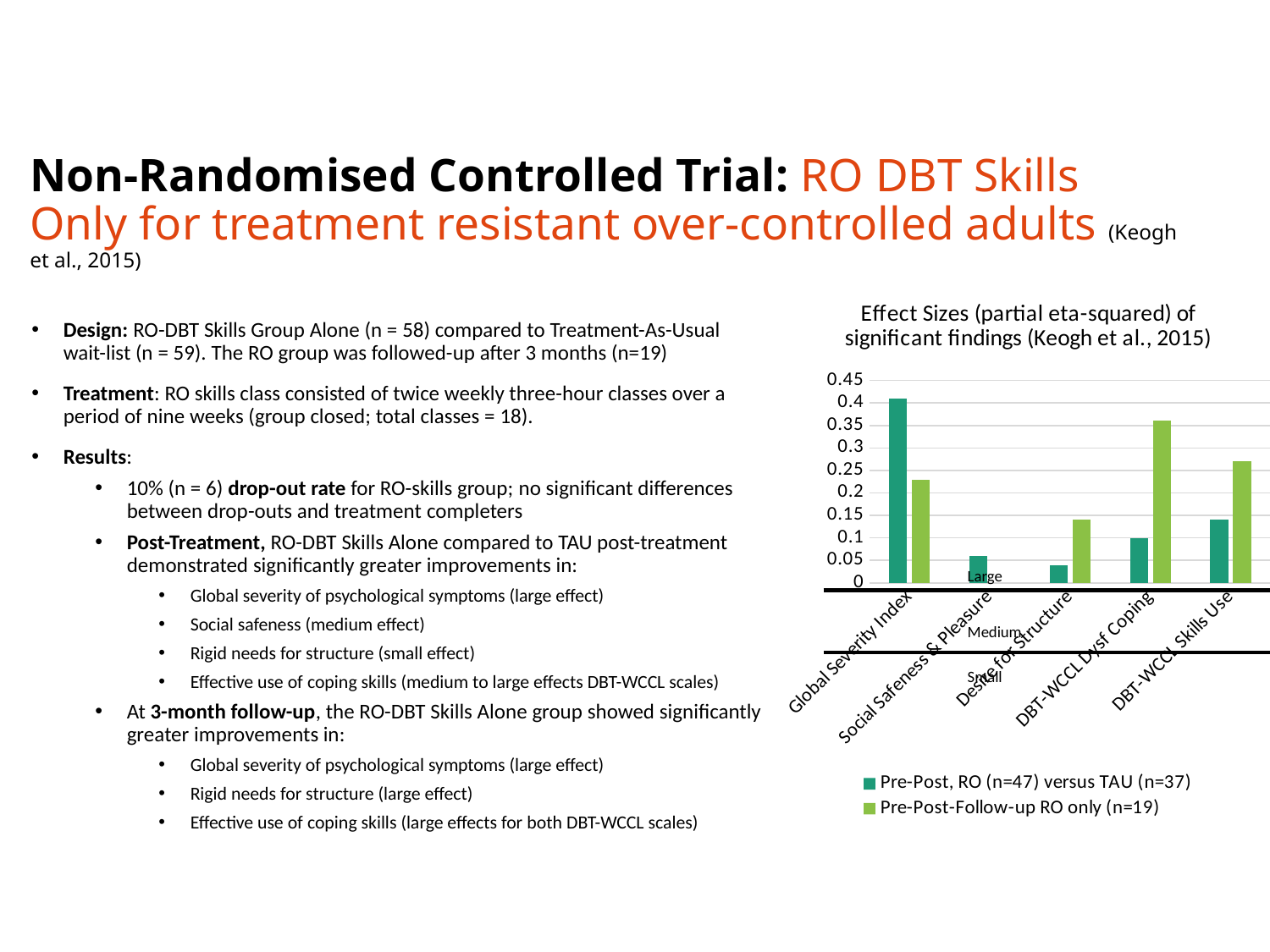
What is the title of the chart? Effect Sizes (partial eta-squared) of significant findings (Keogh et al., 2015) Is the 'Pre-Post, RO (n=47) versus TAU (n=37)' value for Social Safeness & Pleasure greater or less than 0.1? less For DBT-WCCL Dysf Coping, which series has the larger value: 'Pre-Post, RO (n=47) versus TAU (n=37)' or 'Pre-Post-Follow-up RO only (n=19)'? Pre-Post-Follow-up RO only (n=19) Is the 'Pre-Post-Follow-up RO only (n=19)' value for DBT-WCCL Skills Use greater or less than 0.2? greater Is the 'Pre-Post, RO (n=47) versus TAU (n=37)' value for Global Severity Index greater or less than 0.35? greater Which category has the highest value for the 'Pre-Post, RO (n=47) versus TAU (n=37)' series? Global Severity Index How many categories are shown on the x axis of the chart? 5 What kind of chart is shown on the slide? bar chart How many series does the chart's legend list? 2 Which category has the highest value for the 'Pre-Post-Follow-up RO only (n=19)' series? DBT-WCCL Dysf Coping For Global Severity Index, which series has the larger value: 'Pre-Post, RO (n=47) versus TAU (n=37)' or 'Pre-Post-Follow-up RO only (n=19)'? Pre-Post, RO (n=47) versus TAU (n=37)